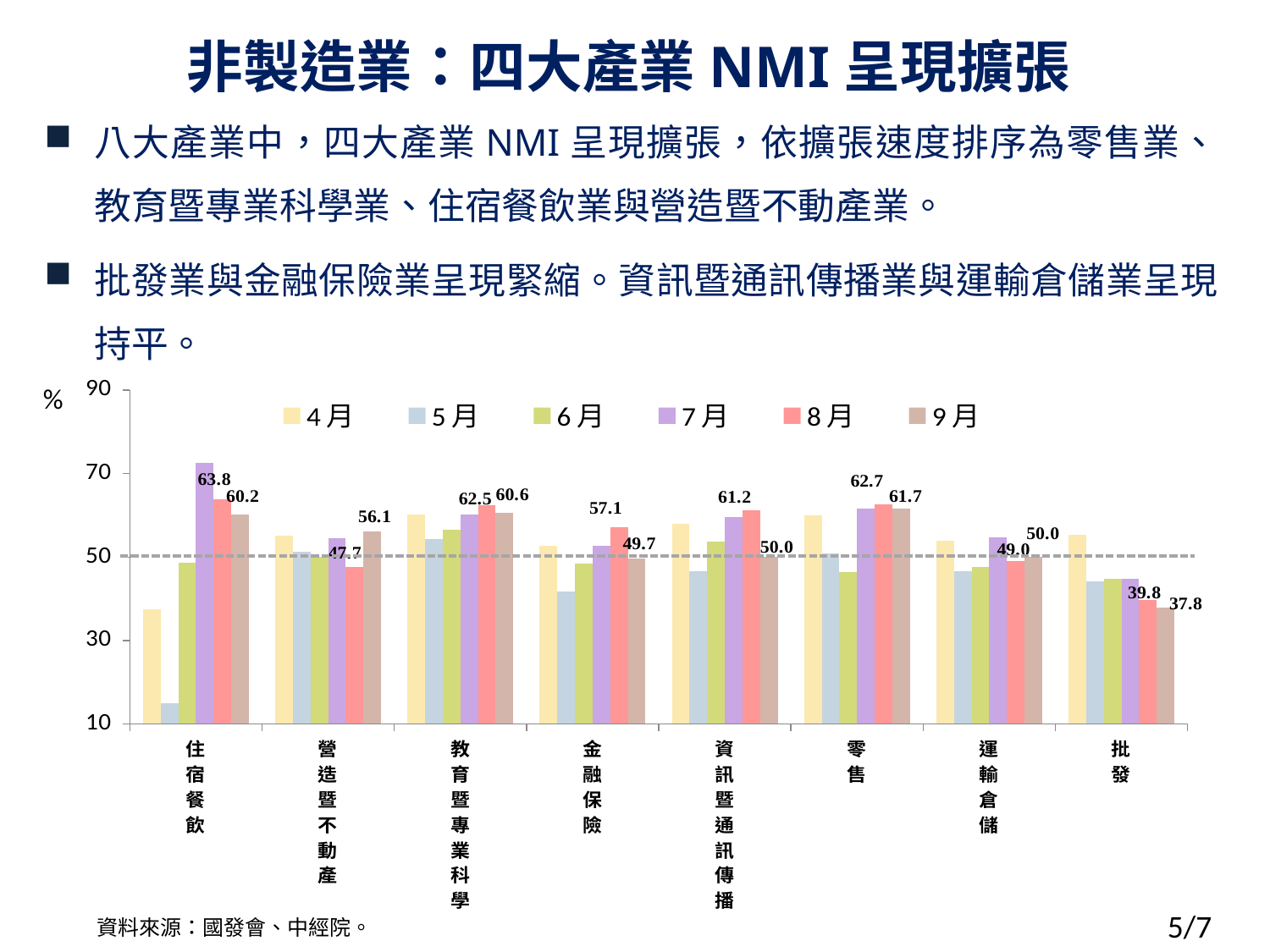
What is the difference between the 8月 and 9月 values for 住宿餐飲? 3.6 What is the 9月 value for 零售? 61.7 How much higher is the 9月 value than the 8月 value for 營造暨不動產? 8.4 How many industries are shown on the x axis? 8 What is the 8月 value for 住宿餐飲? 63.8 Which industry has the highest 9月 value? 零售 How many series does the legend list? 6 What kind of chart is shown on the slide? bar chart Which industry has the lowest 9月 value? 批發 For 金融保險, which is larger: the 8月 value or the 9月 value? 8月 What is the 9月 value for 批發? 37.8 Is the 5月 value for 住宿餐飲 greater or less than 30? less